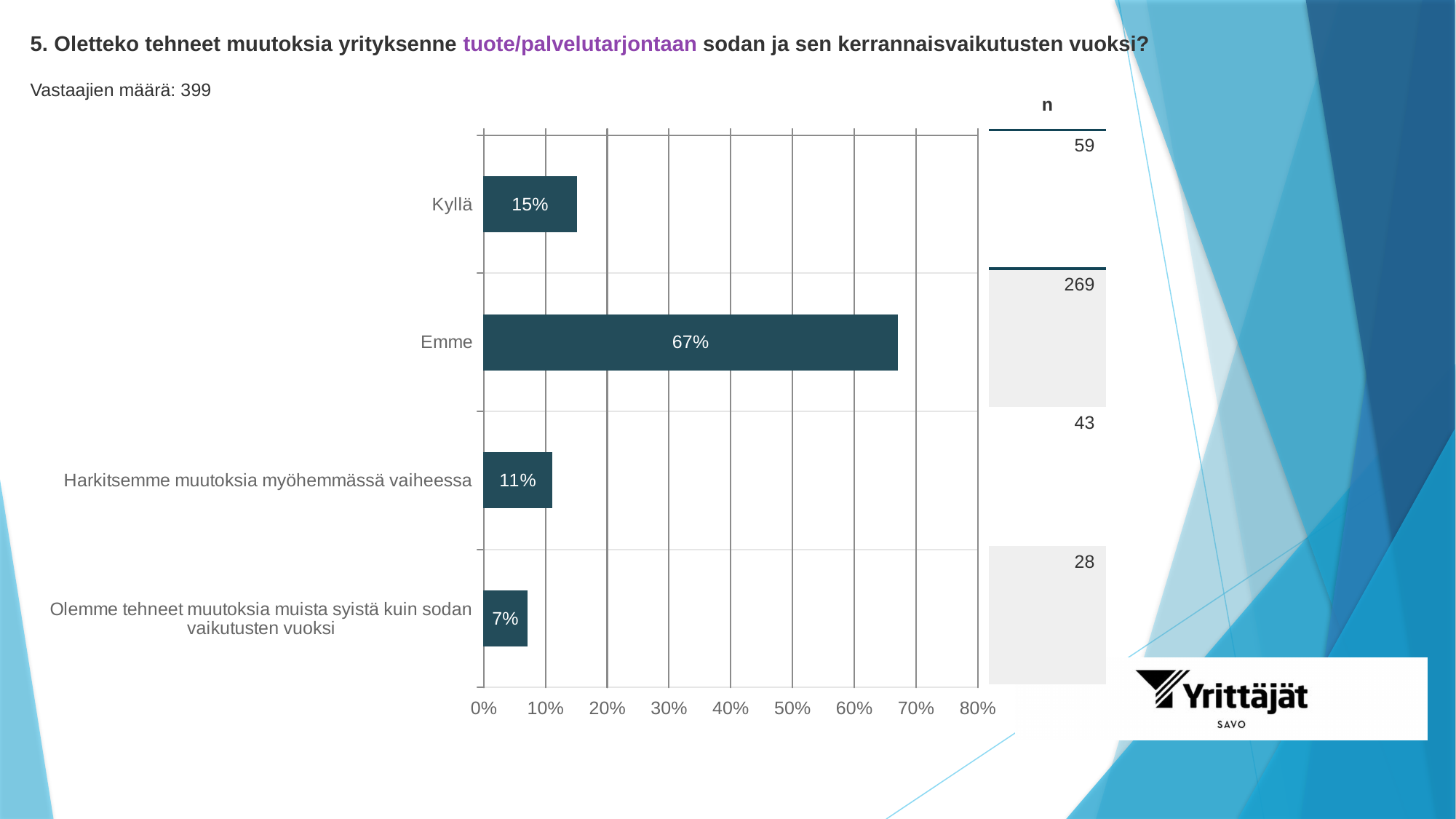
Which is larger, the percentage for "Kyllä" or for "Harkitsemme muutoksia myöhemmässä vaiheessa"? Kyllä What percentage is shown for "Emme"? 67% What is the n value listed for "Kyllä"? 59 Which category has the lowest percentage? Olemme tehneet muutoksia muista syistä kuin sodan vaikutusten vuoksi What percentage is shown for "Olemme tehneet muutoksia muista syistä kuin sodan vaikutusten vuoksi"? 7% What is the n value listed for "Emme"? 269 What percentage is shown for "Harkitsemme muutoksia myöhemmässä vaiheessa"? 11% What kind of chart is shown on the slide? Bar chart How many categories are shown in the chart? 4 Which category has the highest percentage? Emme What is the difference in percentage points between "Emme" and "Kyllä"? 52 What percentage is shown for "Kyllä"? 15%